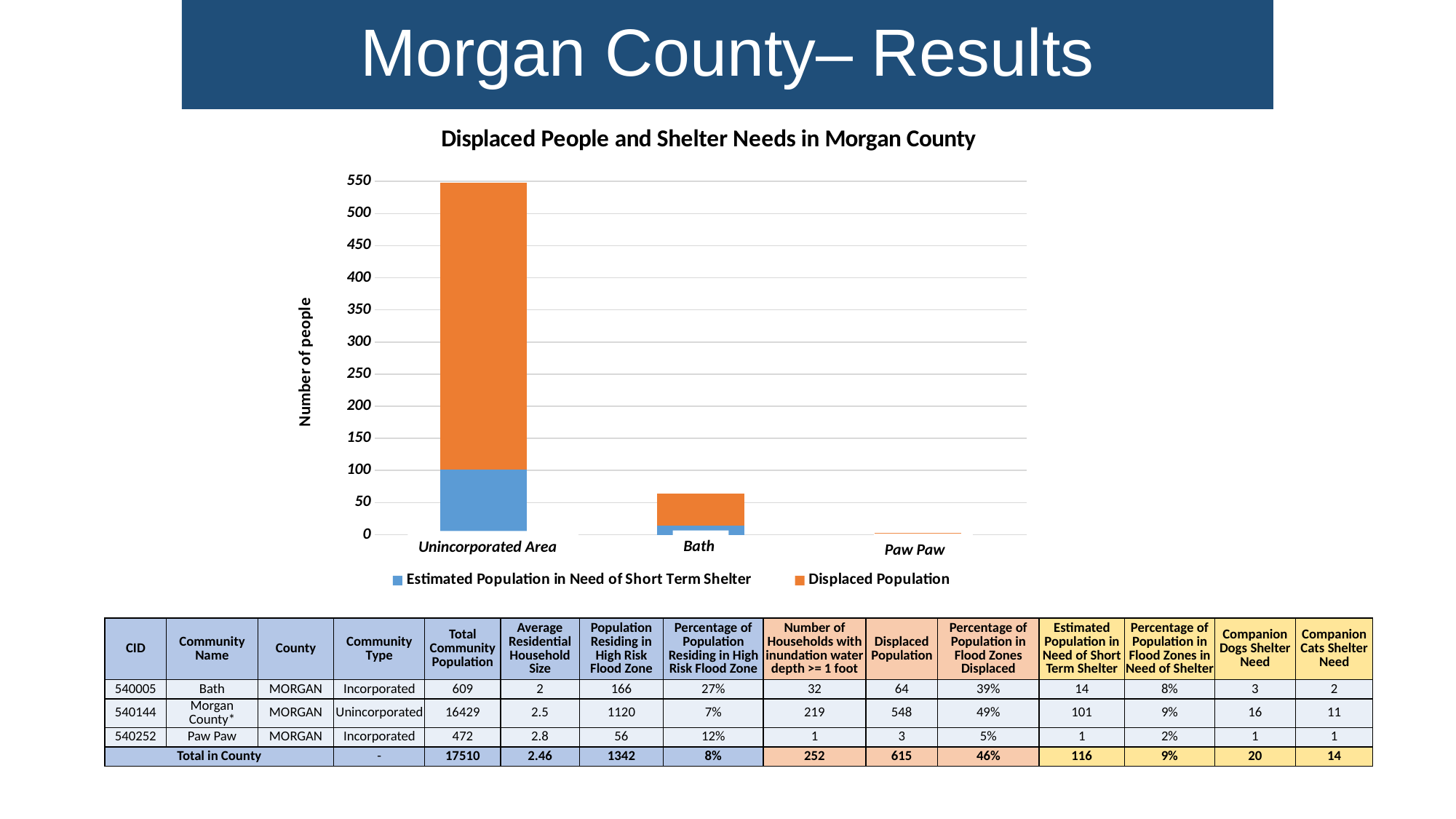
How many categories are shown on the x axis of the chart? 3 Which category has the tallest bar in the chart? Unincorporated Area Is the total bar height for Unincorporated Area greater or less than 500? greater Is the Estimated Population in Need of Short Term Shelter for Unincorporated Area greater or less than 150? less Is the total bar height for Bath greater or less than 50? greater What is the label of the y axis of the chart? Number of people Which category has the shortest bar in the chart? Paw Paw What is the title of the chart? Displaced People and Shelter Needs in Morgan County How many series does the chart legend list? 2 Which has a taller bar, Bath or Paw Paw? Bath What kind of chart is shown on the slide? bar chart